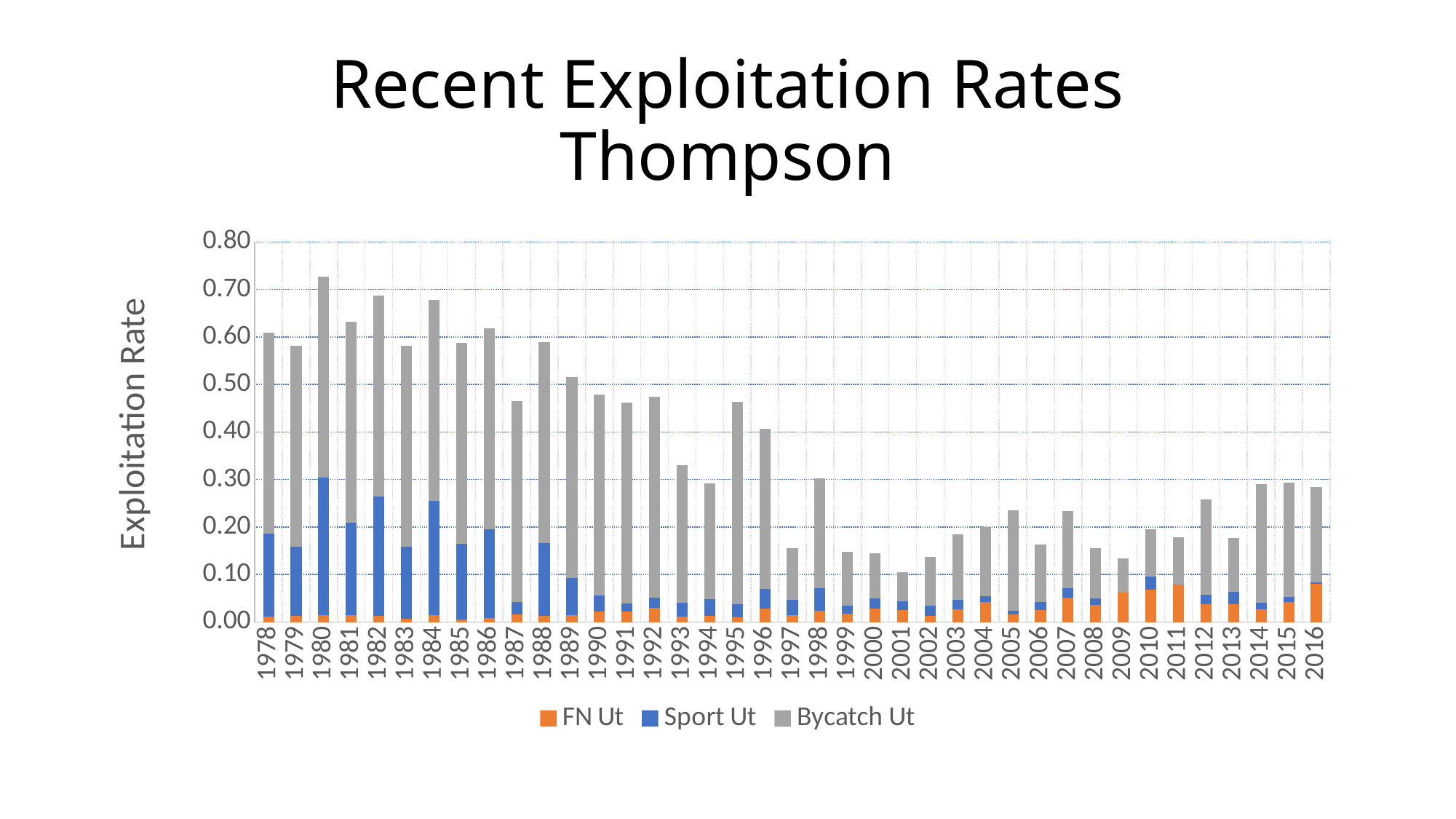
Which year has the larger total exploitation rate, 1982 or 1987? 1982 Is the Sport Ut value for 1980 greater or less than 0.20? greater What is the label on the vertical axis? Exploitation Rate Is the total exploitation rate for 1980 greater or less than 0.60? greater Do total exploitation rates generally rise or fall from 1978 to 2016? fall Which year has the highest total exploitation rate? 1980 How many years are plotted along the x axis? 39 How many series does the legend list? 3 What kind of chart is shown on the slide? Stacked bar chart Which year has the lowest total exploitation rate? 2001 Is the total exploitation rate for 2016 greater or less than 0.40? less